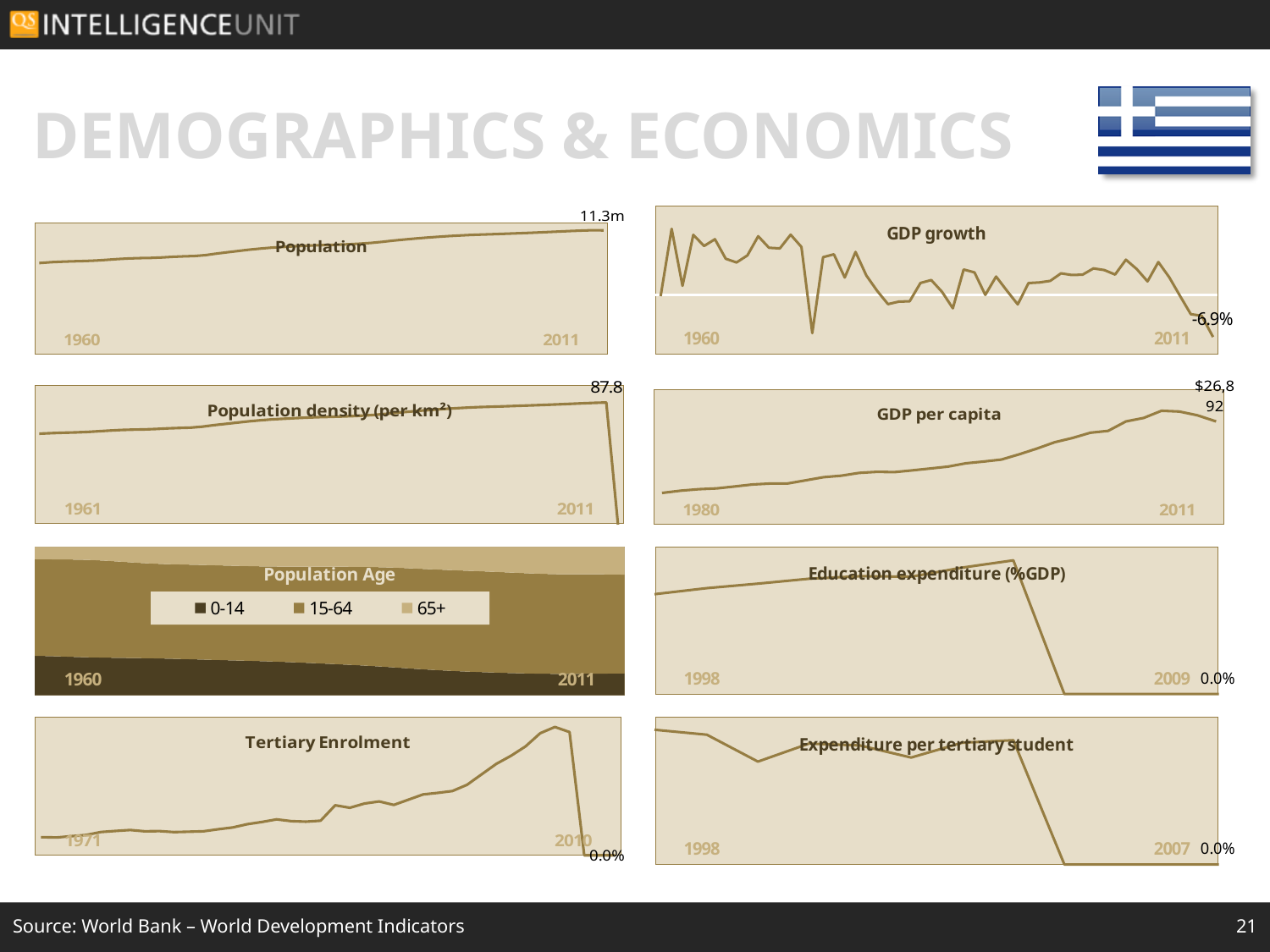
On the Population chart, what value is labelled at the end of the line? 11.3m On the Education expenditure (%GDP) chart, what value is labelled at the end of the line? 0.0% How many series does the legend of the Population Age chart list? 3 On the GDP per capita chart, does the line generally rise or fall from 1980 to 2011? Rise What kind of chart is the Population chart? Line chart On the Population density (per km²) chart, what value is labelled near the end of the line? 87.8 On the GDP growth chart, what value is labelled at the end of the line? -6.9% On the GDP per capita chart, what value is labelled at the end of the line? $26,892 How many charts are shown on the slide? 8 What kind of chart is the Population Age chart? Stacked area chart On the Population chart, does the line rise or fall from 1960 to 2011? Rise What are the legend entries on the Population Age chart? 0-14, 15-64, 65+